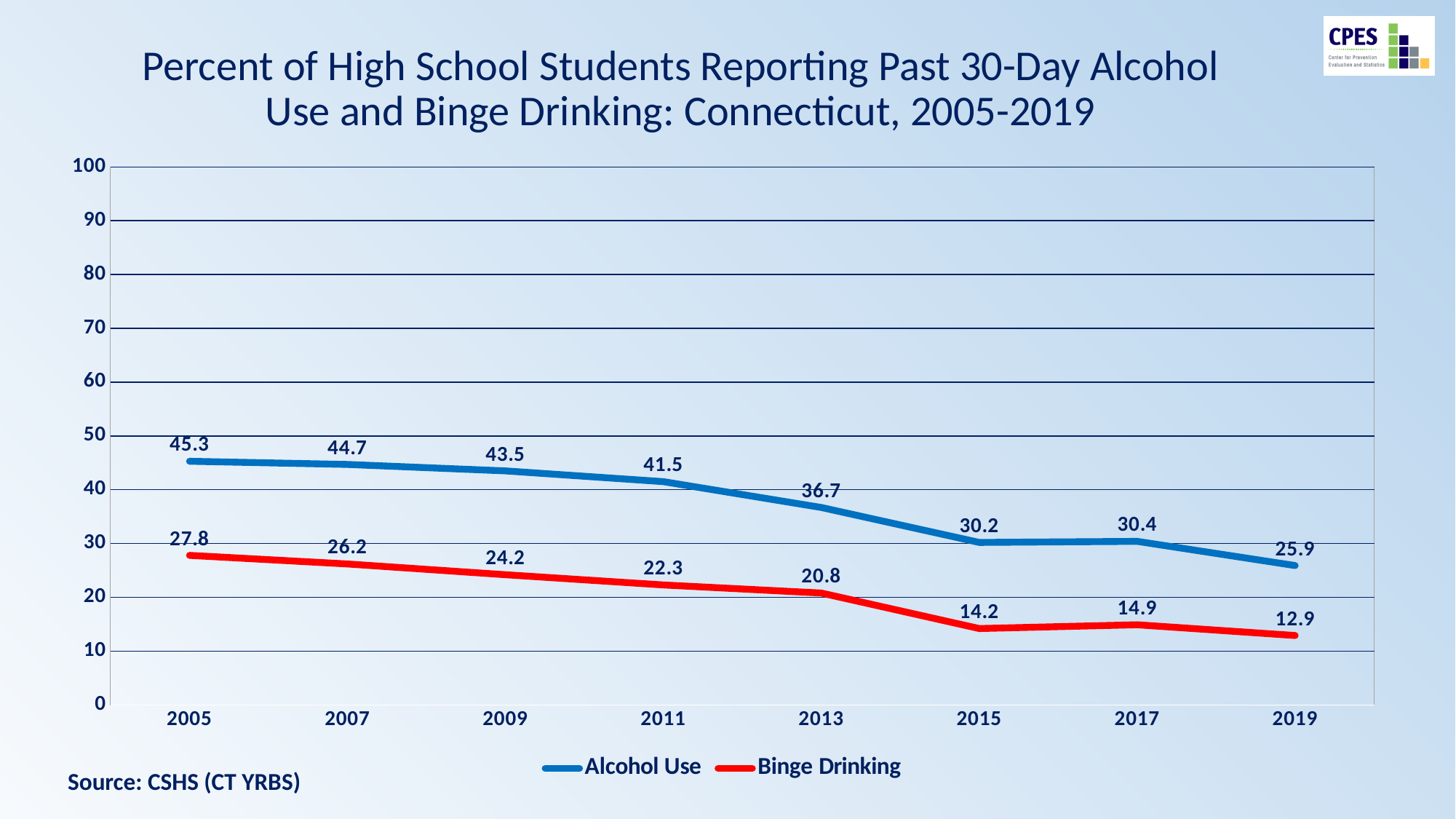
Which was larger in 2017, Alcohol Use or Binge Drinking? Alcohol Use What was the Alcohol Use value in 2019? 25.9 What was the Binge Drinking value in 2013? 20.8 In which year was Alcohol Use highest? 2005 Does Alcohol Use generally rise or fall from 2005 to 2019? Fall In which year was Binge Drinking lowest? 2019 What kind of chart is shown on the slide? Line chart What was the Alcohol Use value in 2005? 45.3 How many years are shown on the x axis? 8 What is the difference between Alcohol Use and Binge Drinking in 2011? 19.2 How many series does the legend list? 2 What colour is the Binge Drinking line? Red